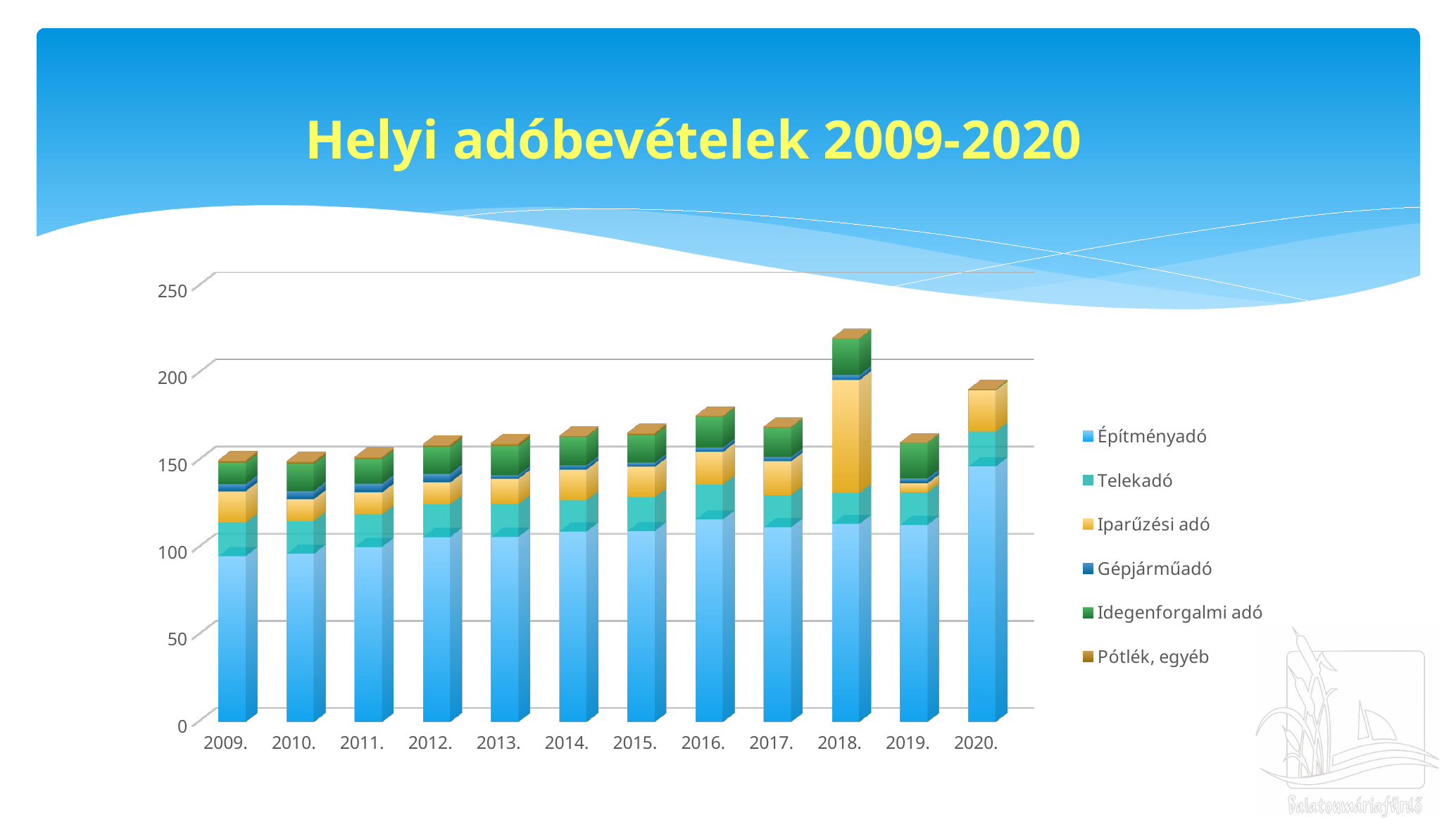
Is the total for 2018. greater or less than 200? greater Which series is listed last in the legend? Pótlék, egyéb Is the Építményadó value for 2020. greater or less than 100? greater What is the title of the chart? Helyi adóbevételek 2009-2020 Which year has the highest total stacked bar? 2018. What kind of chart is shown on the slide? Stacked bar chart How many years (categories) are shown on the x axis? 12 Which year has the larger total, 2010. or 2016.? 2016. How many series does the legend list? 6 Which year has the larger total, 2018. or 2020.? 2018. Is the total for 2016. greater or less than 150? greater